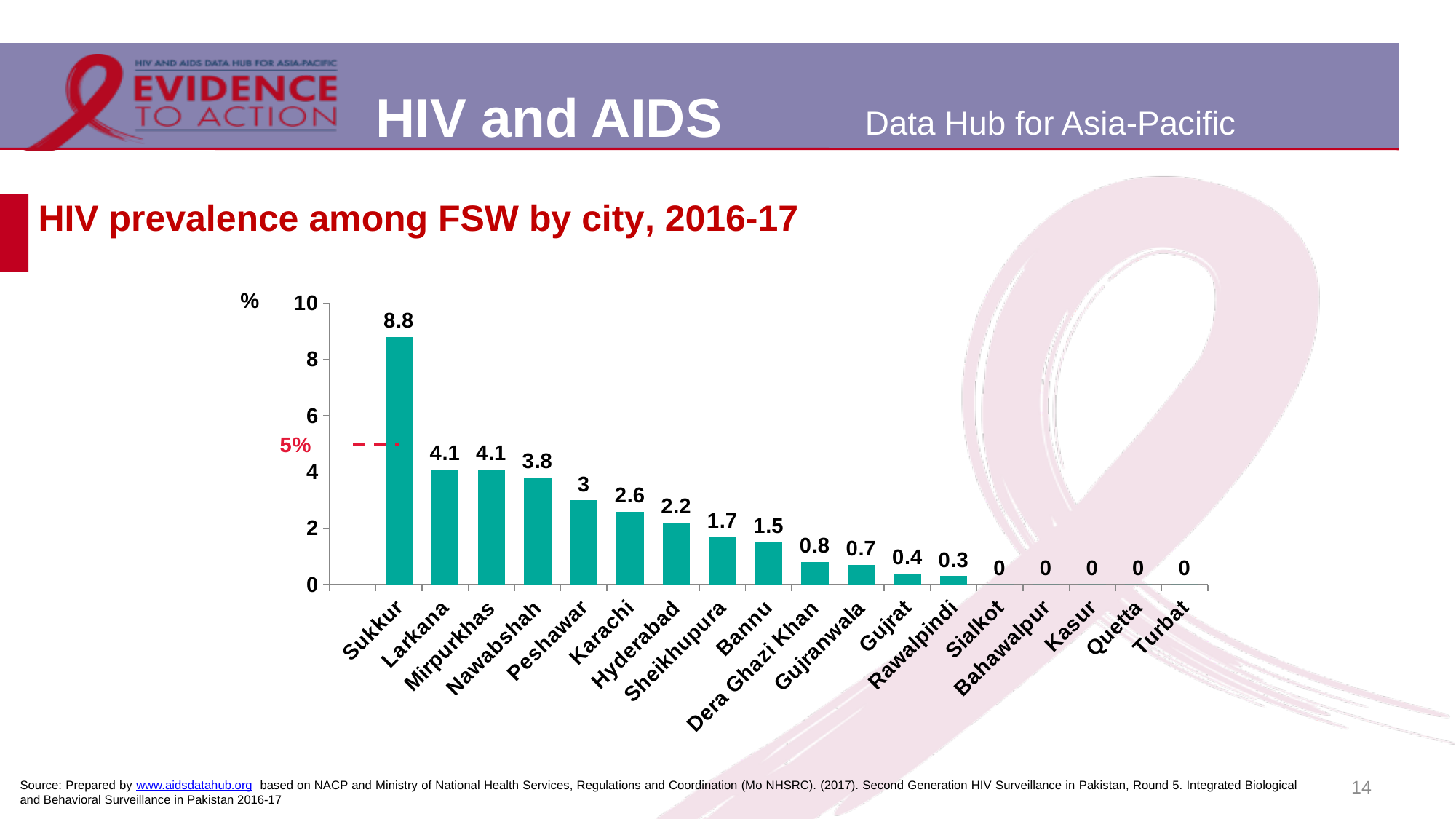
Is the value for Sukkur greater or less than 8? greater How many cities have an HIV prevalence of 0? 5 What value does the red dashed reference line on the chart mark? 5% Which city has a higher HIV prevalence among FSW, Peshawar or Hyderabad? Peshawar Which city has the highest HIV prevalence among FSW? Sukkur What is the difference in HIV prevalence between Sukkur and Nawabshah? 5 What kind of chart is shown on the slide? Bar chart What is the HIV prevalence among FSW in Sukkur? 8.8 Do the values rise or fall from left to right along the x axis? Fall What is the HIV prevalence among FSW in Karachi? 2.6 How many cities are shown on the chart? 18 What is the HIV prevalence among FSW in Dera Ghazi Khan? 0.8